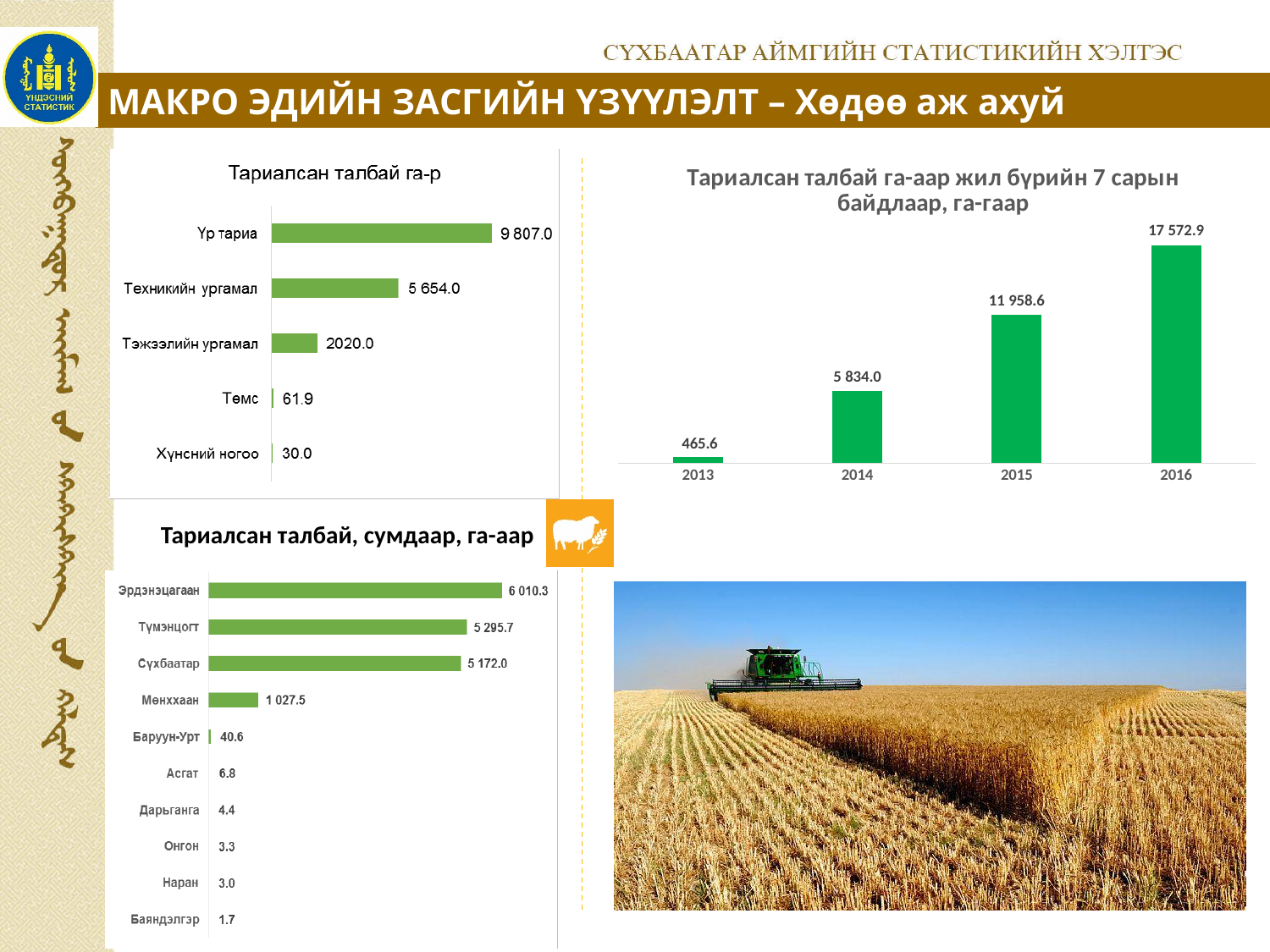
In the chart titled "Тариалсан талбай, сумдаар, га-аар", how many sums are listed? 10 In the chart titled "Тариалсан талбай га-аар жил бүрийн 7 сарын байдлаар, га-гаар", do the values rise or fall from 2013 to 2016? rise In the chart titled "Тариалсан талбай га-аар жил бүрийн 7 сарын байдлаар, га-гаар", which year has the highest value? 2016 In the chart titled "Тариалсан талбай га-аар жил бүрийн 7 сарын байдлаар, га-гаар", what is the value for 2015? 11 958.6 In the chart titled "Тариалсан талбай га-р", what is the difference between Үр тариа and Техникийн ургамал? 4 153.0 In the chart titled "Тариалсан талбай, сумдаар, га-аар", what is the value for Мөнххаан? 1 027.5 In the chart titled "Тариалсан талбай, сумдаар, га-аар", which is larger, Түмэнцогт or Сүхбаатар? Түмэнцогт In the chart titled "Тариалсан талбай, сумдаар, га-аар", which sum has the highest value? Эрдэнэцагаан In the chart titled "Тариалсан талбай га-р", which category has the lowest value? Хүнсний ногоо In the chart titled "Тариалсан талбай га-аар жил бүрийн 7 сарын байдлаар, га-гаар", what kind of chart is it? bar chart In the chart titled "Тариалсан талбай га-р", how many categories are shown? 5 In the chart titled "Тариалсан талбай га-р", what is the value for Үр тариа? 9 807.0